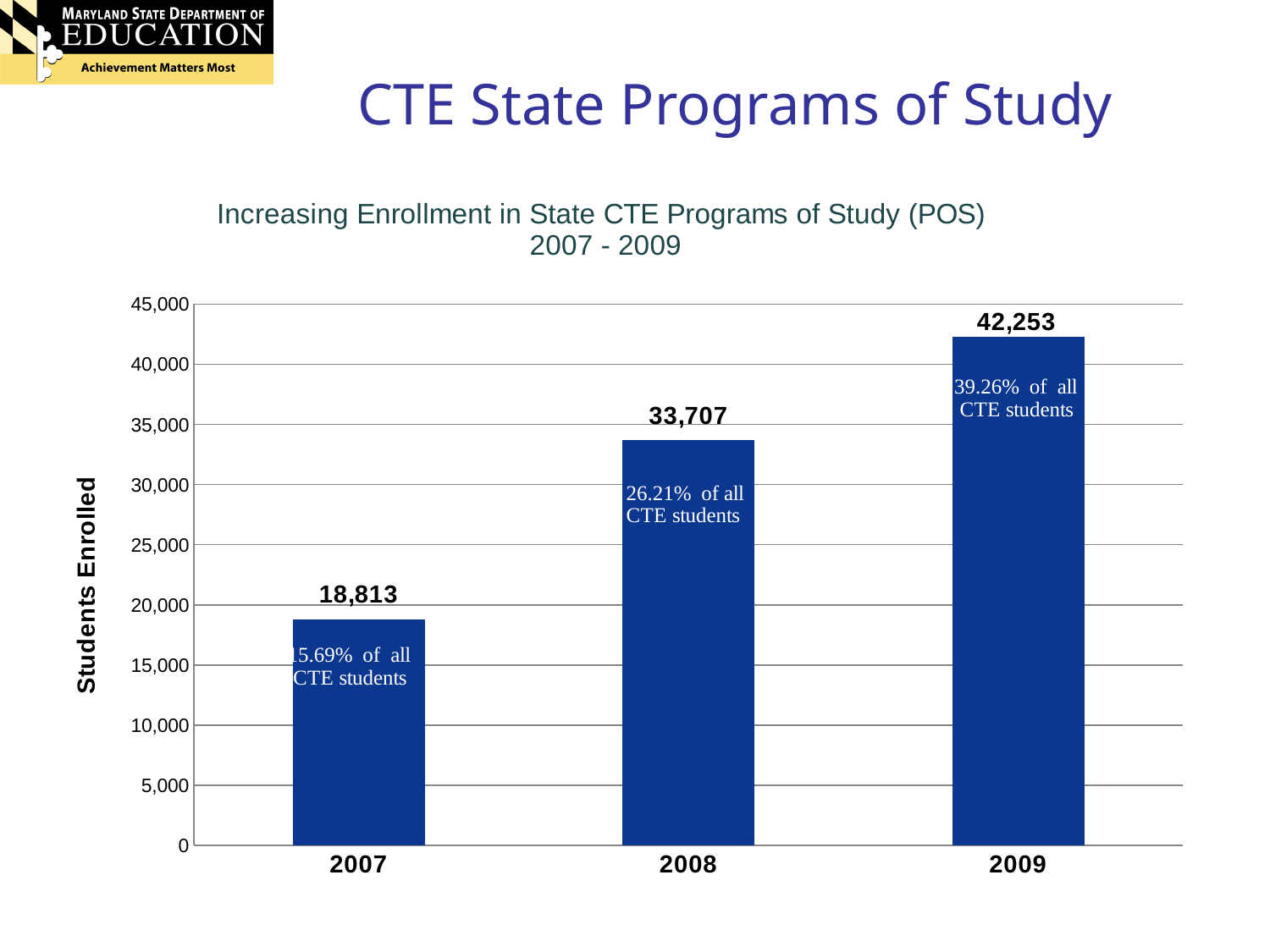
How many students were enrolled in State CTE Programs of Study in 2007? 18,813 Which year had the lowest enrollment in State CTE Programs of Study? 2007 What kind of chart is shown on the slide? Bar chart Which year had the highest enrollment in State CTE Programs of Study? 2009 What percentage of all CTE students were enrolled in State Programs of Study in 2009? 39.26% What is the difference in enrollment between 2009 and 2007? 23,440 How many years are shown on the chart? 3 How many students were enrolled in State CTE Programs of Study in 2008? 33,707 What is the difference in enrollment between 2008 and 2007? 14,894 How many students were enrolled in State CTE Programs of Study in 2009? 42,253 Is the enrollment for 2008 greater or less than 30,000? greater Which year had higher enrollment, 2008 or 2009? 2009